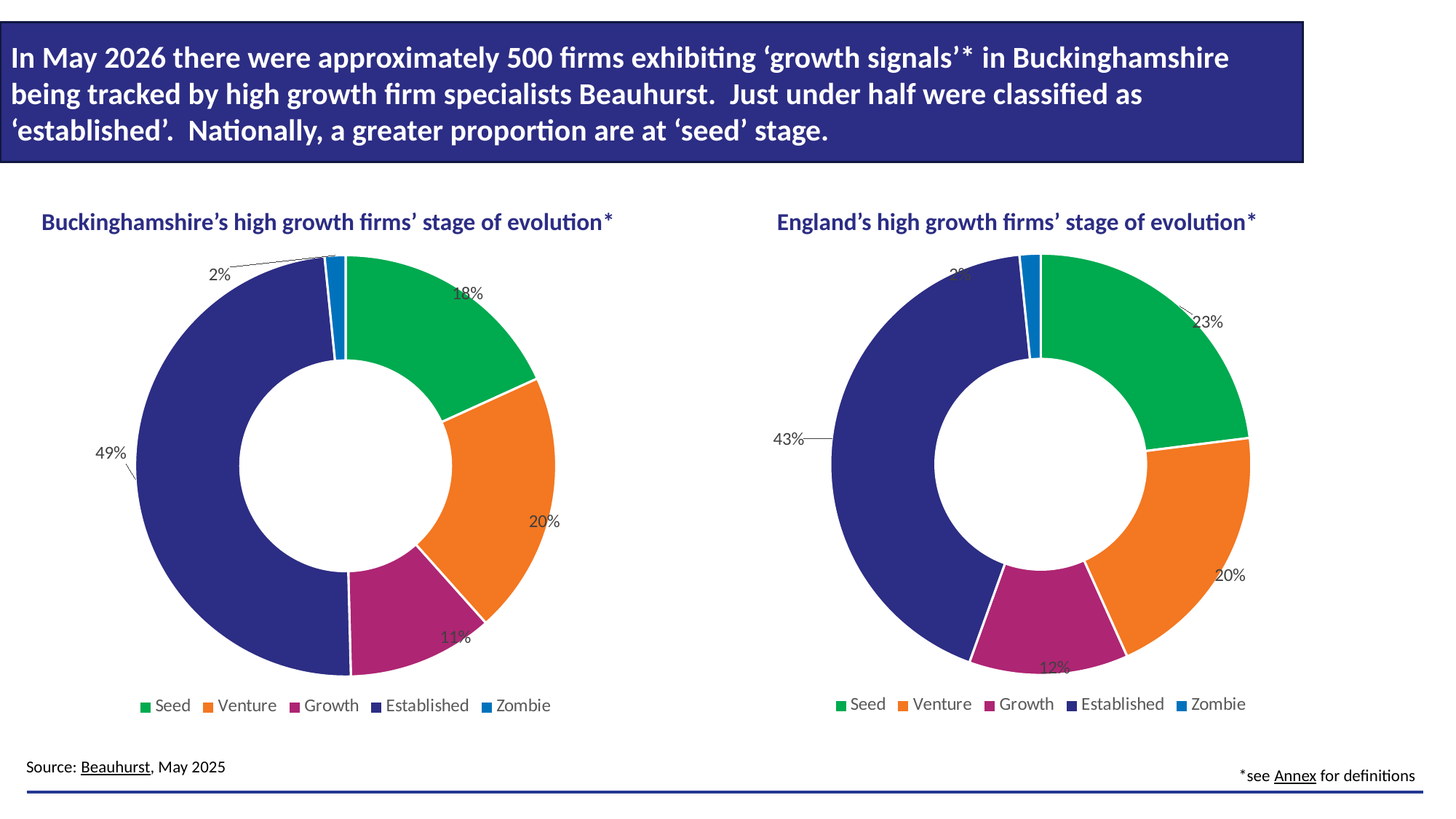
In the Buckinghamshire's high growth firms' stage of evolution chart, is the Venture share larger or smaller than the Seed share? larger In the England's high growth firms' stage of evolution chart, what share of firms are at the Growth stage? 12% In the Buckinghamshire's high growth firms' stage of evolution chart, what is the difference between the Venture share and the Growth share? 9% In the Buckinghamshire's high growth firms' stage of evolution chart, what share of firms are at the Established stage? 49% What kind of chart is the Buckinghamshire's high growth firms' stage of evolution chart? Doughnut (pie) chart In the Buckinghamshire's high growth firms' stage of evolution chart, what share of firms are at the Seed stage? 18% How many categories does the legend of the England's high growth firms' stage of evolution chart list? 5 In the Buckinghamshire's high growth firms' stage of evolution chart, which stage has the largest share? Established In the England's high growth firms' stage of evolution chart, what colour represents the Established stage? Dark blue Which chart shows a larger share for the Seed stage, Buckinghamshire's or England's? England's In the England's high growth firms' stage of evolution chart, what share of firms are at the Seed stage? 23% In the England's high growth firms' stage of evolution chart, which stage has the smallest share? Zombie